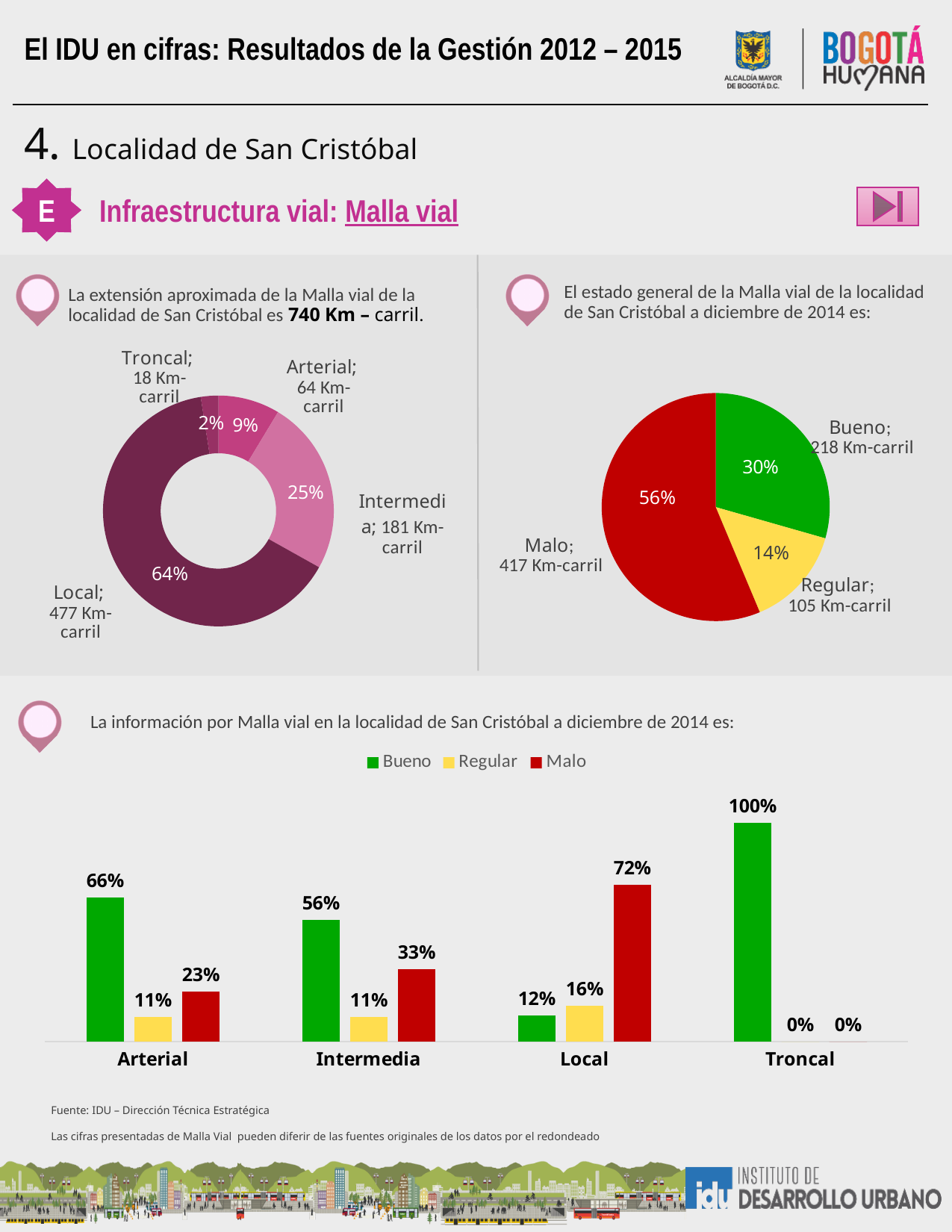
In the doughnut chart on the left, which category has the smallest share? Troncal In the pie chart on the right, how many Km-carril are in Bueno condition? 218 Km-carril In the doughnut chart on the left, how many categories are shown? 4 In the pie chart on the right (estado general de la Malla vial), what percentage is Malo? 56% In the doughnut chart on the left (extension of the Malla vial), what percentage does Local represent? 64% In the doughnut chart on the left, how many Km-carril does Intermedia account for? 181 Km-carril In the bottom bar chart, which category has the highest Bueno value? Troncal In the bottom bar chart, is the Bueno value for Arterial larger or smaller than the Bueno value for Intermedia? larger In the pie chart on the right, what is the difference in percentage points between Malo and Regular? 42 In the bottom bar chart, what is the Malo value for Local? 72% In the bottom bar chart, how many series does the legend list? 3 In the pie chart on the right, which category has the largest share? Malo